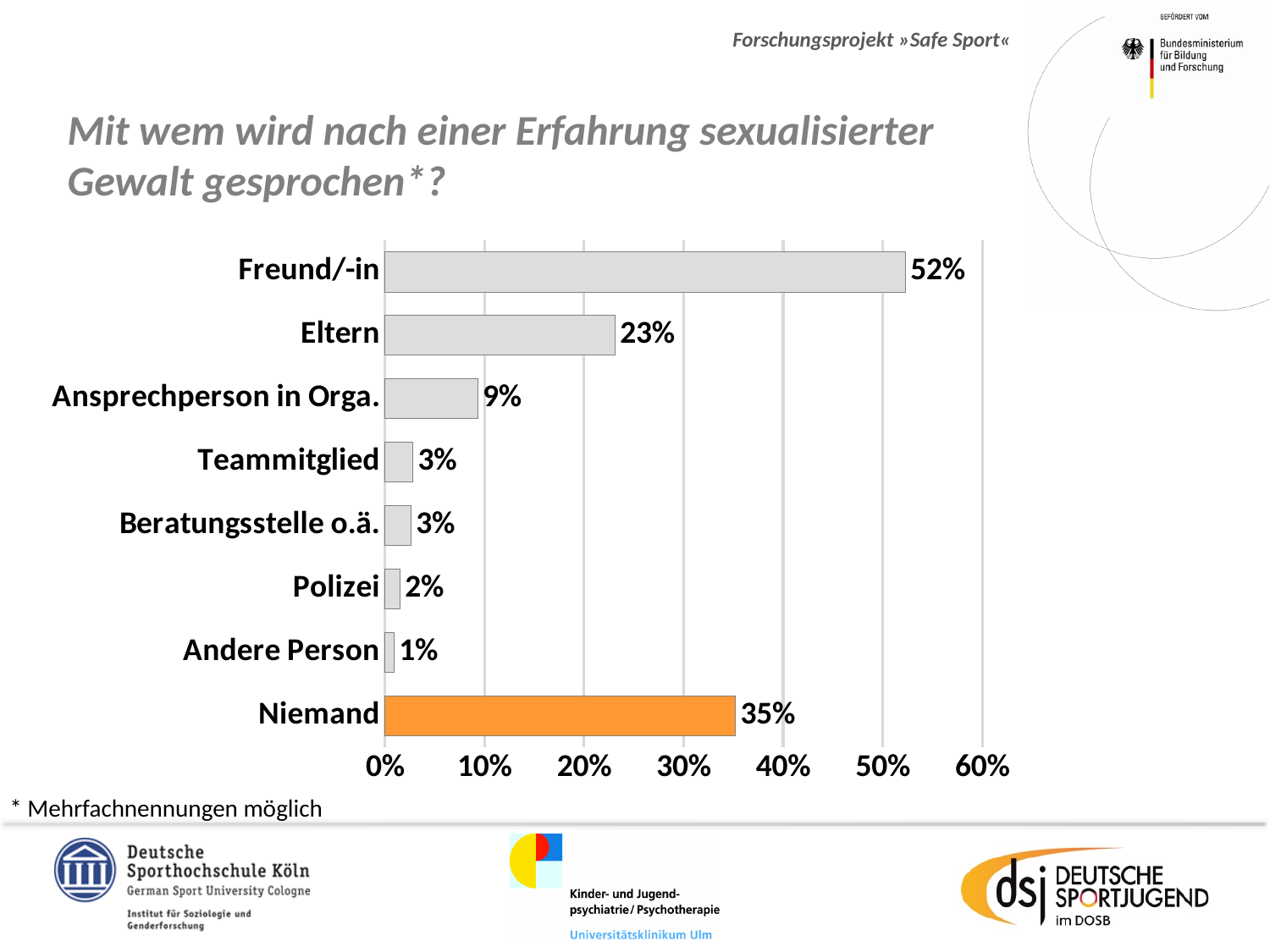
What is the value for Ansprechperson in Orga.? 9% Which category has the lowest value? Andere Person What kind of chart is shown on the slide? bar chart What is the difference between the values for Freund/-in and Niemand? 17% What is the value for Freund/-in? 52% How many categories are shown in the chart? 8 Which bar is coloured orange rather than grey? Niemand Which is larger, the value for Eltern or the value for Niemand? Niemand Which category has the highest value? Freund/-in Is the value for Eltern greater or less than 20%? greater What is the value for Niemand? 35% What is the value for Eltern? 23%